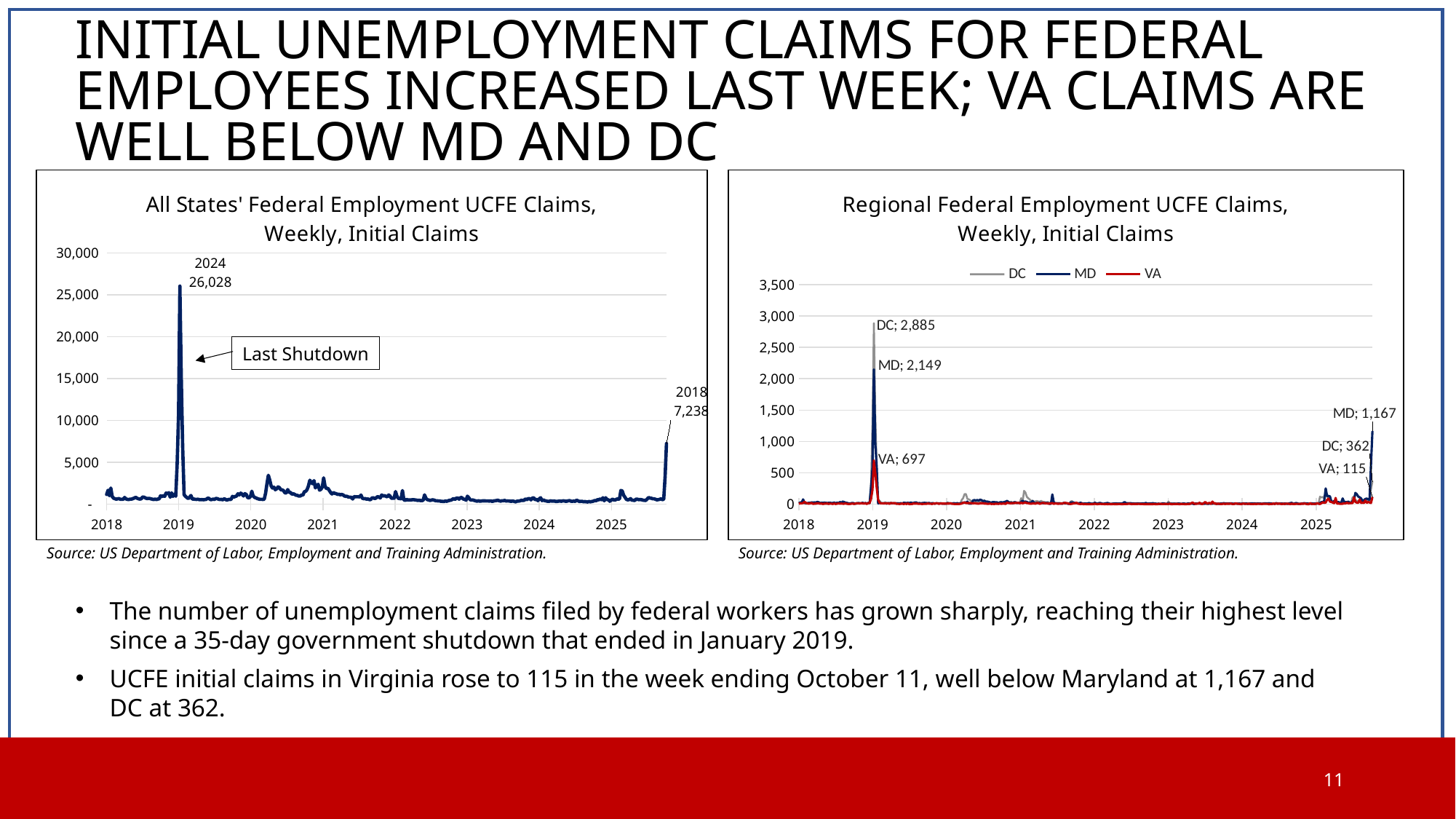
In the 'All States' Federal Employment UCFE Claims' chart, what is the labelled value at the end of the series? 7,238 In the 'Regional Federal Employment UCFE Claims' chart, what is the labelled DC value at the 2019 peak? 2,885 How many series does the legend of the 'Regional Federal Employment UCFE Claims' chart list? 3 What kind of chart is the 'All States' Federal Employment UCFE Claims, Weekly, Initial Claims' chart? Line chart In the 'All States' Federal Employment UCFE Claims' chart, is the value during 2022 greater or less than 5,000? less In the 'All States' Federal Employment UCFE Claims' chart, what does the annotation box pointing at the 2019 spike say? Last Shutdown In the 'All States' Federal Employment UCFE Claims' chart, what is the value of the labelled peak in 2019? 26,028 In the 'Regional Federal Employment UCFE Claims' chart, what is the labelled VA value at the 2019 peak? 697 In the 'All States' Federal Employment UCFE Claims' chart, what is the difference between the 2019 peak (26,028) and the final labelled value (7,238)? 18,790 In the 'Regional Federal Employment UCFE Claims' chart, what is the latest labelled value for MD? 1,167 In the 'Regional Federal Employment UCFE Claims' chart, which series has the highest value at the 2019 peak? DC In the 'Regional Federal Employment UCFE Claims' chart, what is the difference between the latest labelled MD value (1,167) and the latest labelled VA value (115)? 1,052